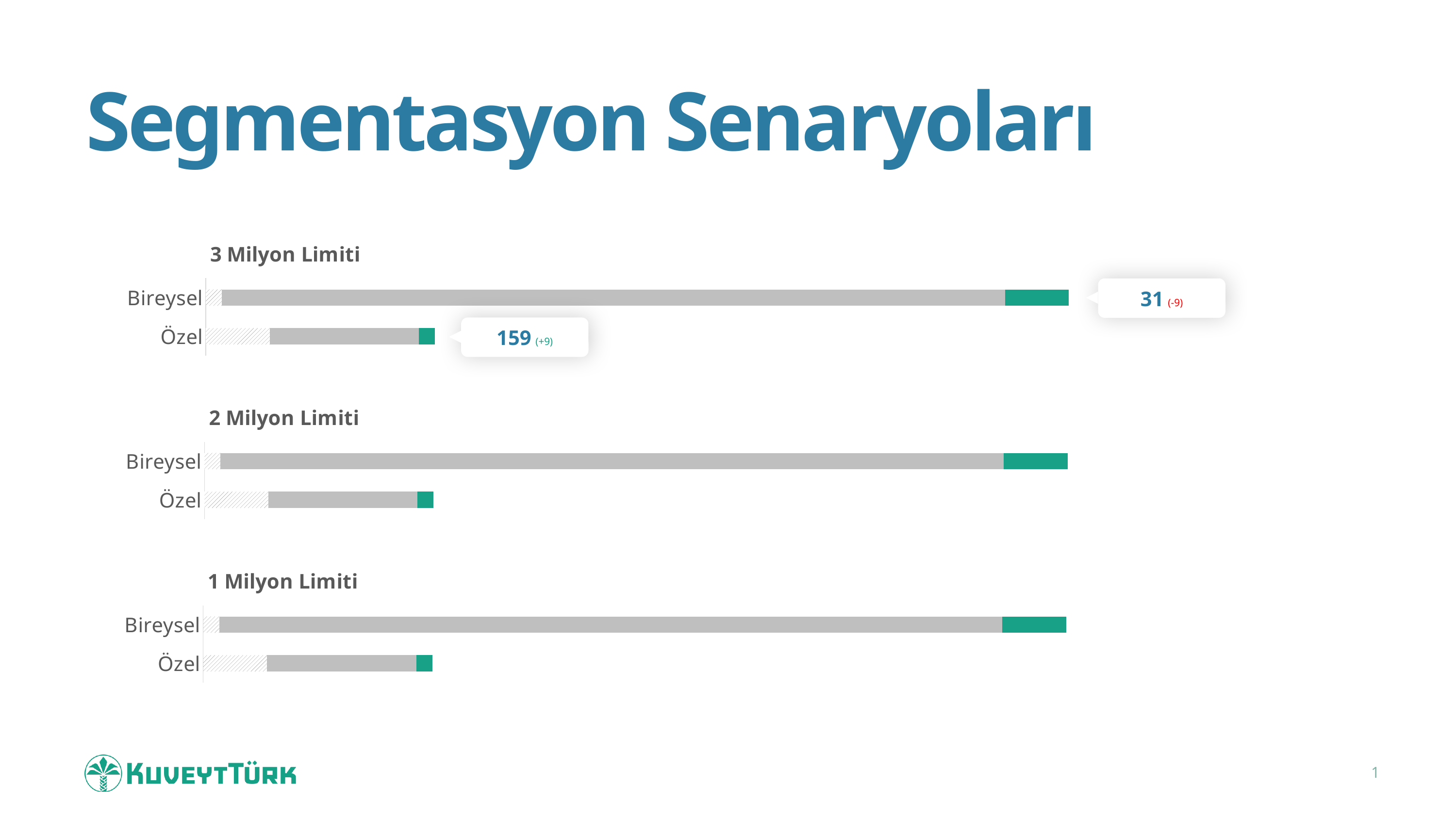
In the 3 Milyon Limiti chart, what value is shown for Özel? 159 In the 3 Milyon Limiti chart, what change is shown in parentheses next to the Bireysel value? (-9) In the 3 Milyon Limiti chart, what is the difference between the Özel value and the Bireysel value? 128 How many categories does the 1 Milyon Limiti chart show? 2 How many categories does the 2 Milyon Limiti chart show? 2 What kind of chart is the 2 Milyon Limiti chart? Bar chart How many charts are shown on the slide? 3 In the 3 Milyon Limiti chart, which labelled value is larger, Bireysel or Özel? Özel What is the title of the top chart on the slide? 3 Milyon Limiti In the 3 Milyon Limiti chart, what change is shown in parentheses next to the Özel value? (+9) In the 3 Milyon Limiti chart, what value is shown for Bireysel? 31